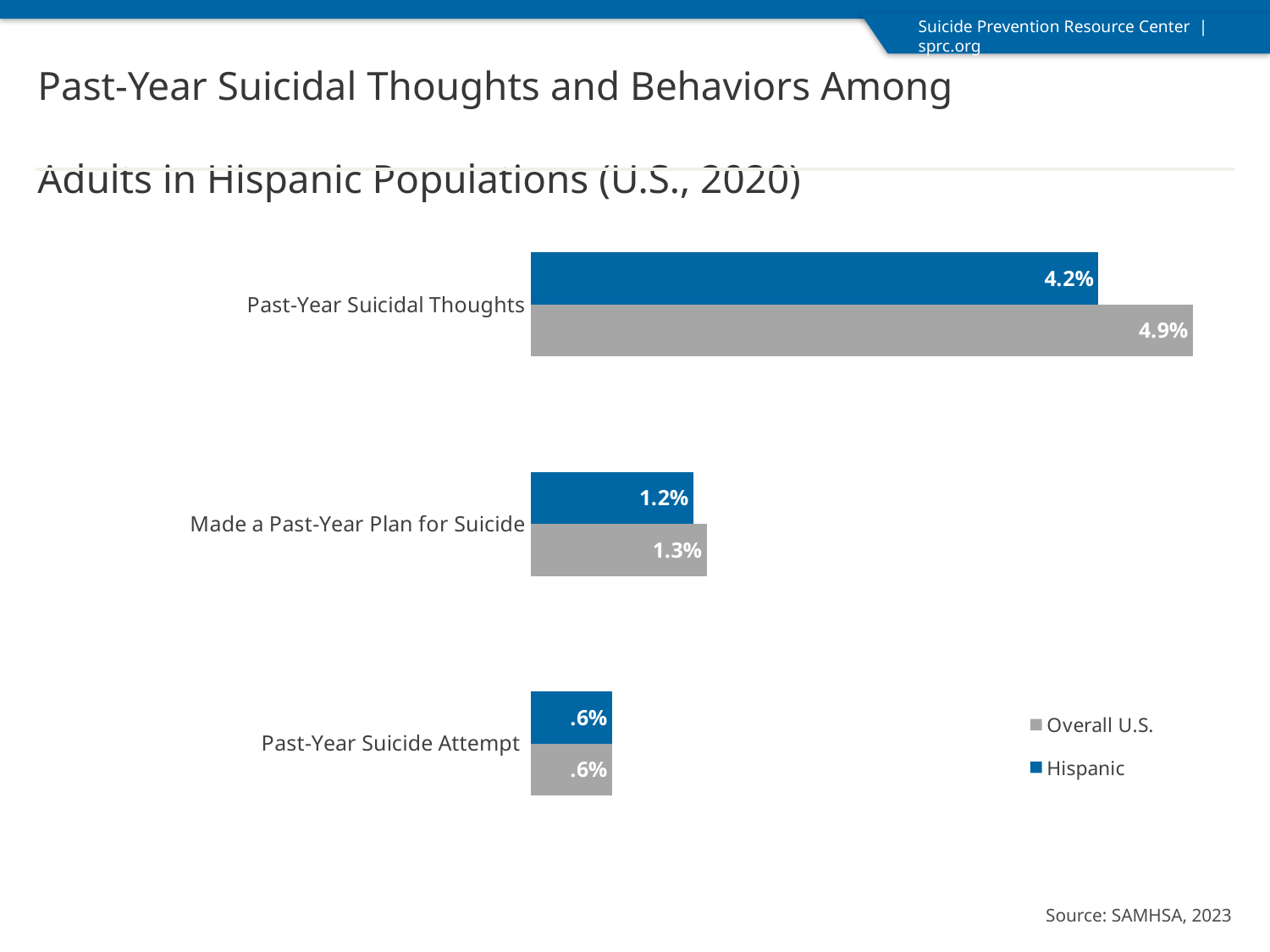
How many series does the legend list? 2 Which category has the lowest Hispanic value? Past-Year Suicide Attempt What is the difference between the Overall U.S. and Hispanic values for Past-Year Suicidal Thoughts? 0.7% What kind of chart is shown on the slide? Bar chart What is the Hispanic value for Made a Past-Year Plan for Suicide? 1.2% Which category has the highest Overall U.S. value? Past-Year Suicidal Thoughts What is the Overall U.S. value for Made a Past-Year Plan for Suicide? 1.3% What is the Hispanic value for Past-Year Suicidal Thoughts? 4.2% How many categories are shown in the chart? 3 For Made a Past-Year Plan for Suicide, which is larger: the Overall U.S. value or the Hispanic value? Overall U.S. What is the Overall U.S. value for Past-Year Suicidal Thoughts? 4.9% What is the Hispanic value for Past-Year Suicide Attempt? .6%